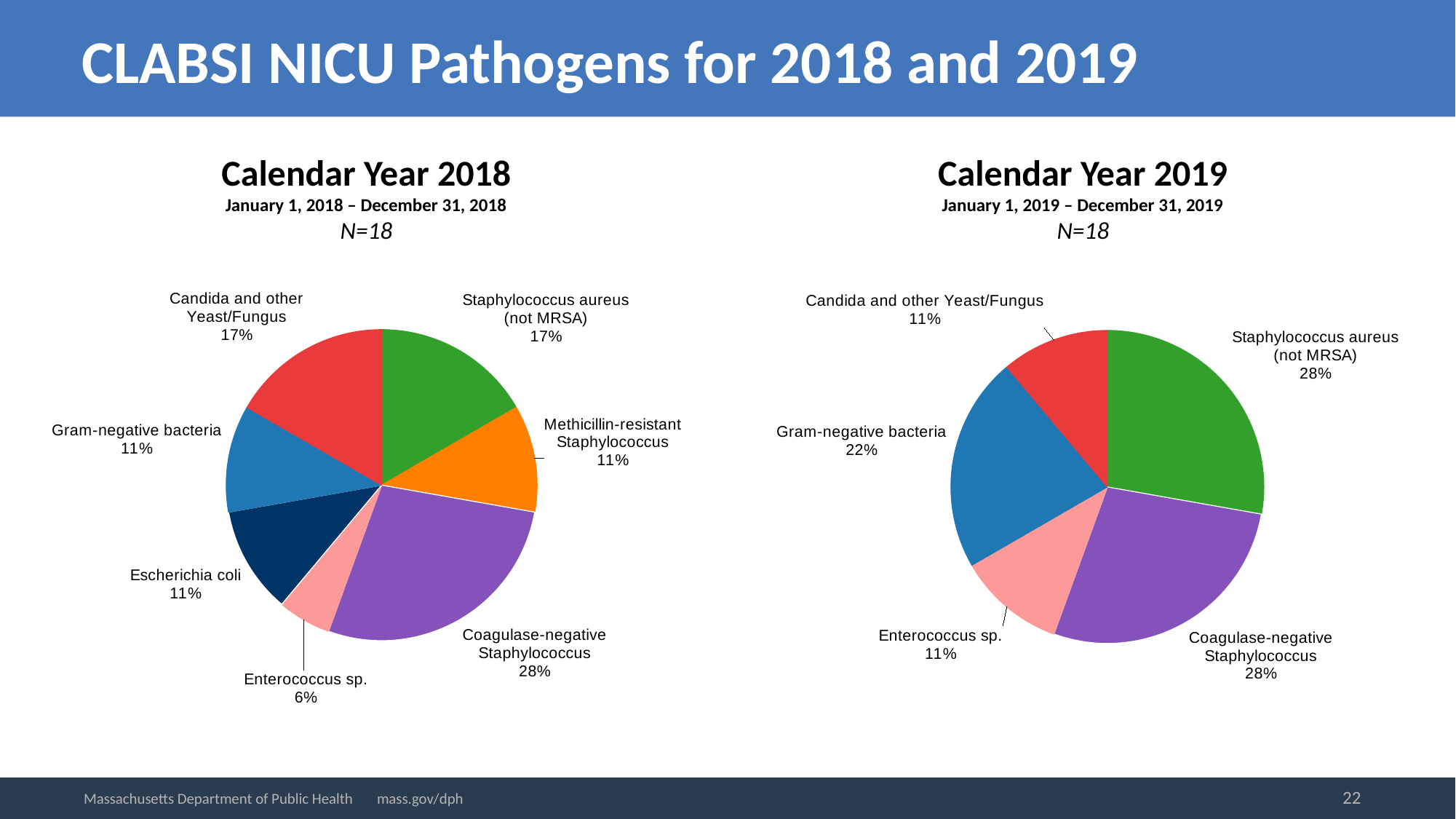
How many slices does the Calendar Year 2018 pie chart have? 7 In the Calendar Year 2019 pie chart, which is larger: Gram-negative bacteria or Candida and other Yeast/Fungus? Gram-negative bacteria In the Calendar Year 2019 pie chart, what share is Gram-negative bacteria? 22% How many slices does the Calendar Year 2019 pie chart have? 5 In the Calendar Year 2019 pie chart, what is the difference between the shares of Staphylococcus aureus (not MRSA) and Enterococcus sp.? 17% What type of chart is used for Calendar Year 2019? Pie chart In the Calendar Year 2018 pie chart, what share is Enterococcus sp.? 6% In the Calendar Year 2018 pie chart, what is the difference between the shares of Coagulase-negative Staphylococcus and Methicillin-resistant Staphylococcus? 17% In the Calendar Year 2018 pie chart, which pathogen has the smallest share? Enterococcus sp. In the Calendar Year 2018 pie chart, which pathogen has the largest share? Coagulase-negative Staphylococcus In the Calendar Year 2019 pie chart, what share is Candida and other Yeast/Fungus? 11% In the Calendar Year 2018 pie chart, what share is Coagulase-negative Staphylococcus? 28%